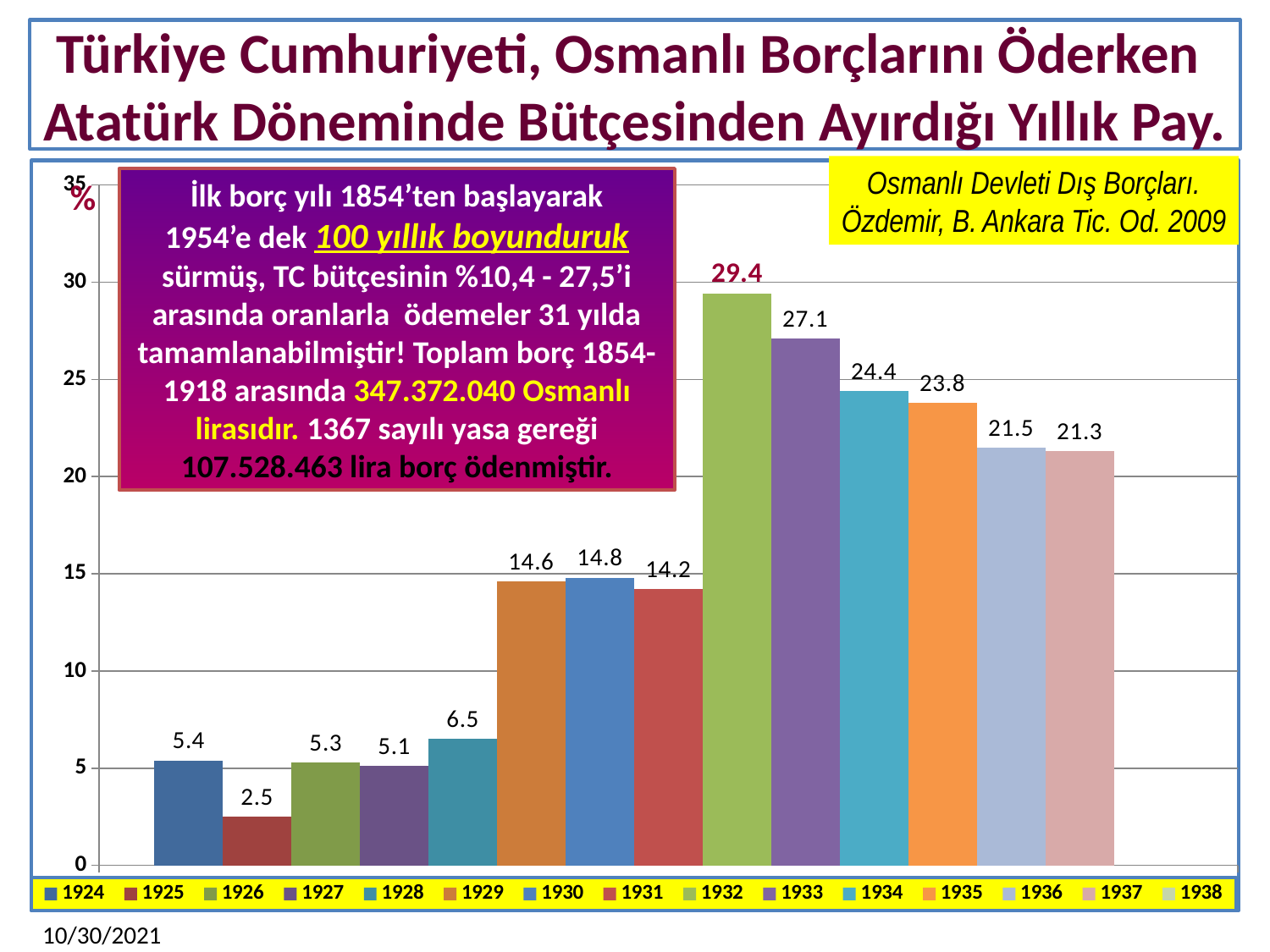
Which year has the lowest bar? 1925 Which is larger, the value for 1934 or the value for 1935? 1934 Which year has the highest bar? 1932 Is the value for 1933 greater or less than 25? greater Do the values rise or fall from 1932 to 1937? fall What is the difference between the values for 1932 and 1933? 2.3 What is the difference between the values for 1928 and 1925? 4.0 What kind of chart is shown on the slide? bar chart How many entries does the legend list? 15 What is the value shown for 1930? 14.8 What is the value shown for 1925? 2.5 What is the value shown for 1932? 29.4